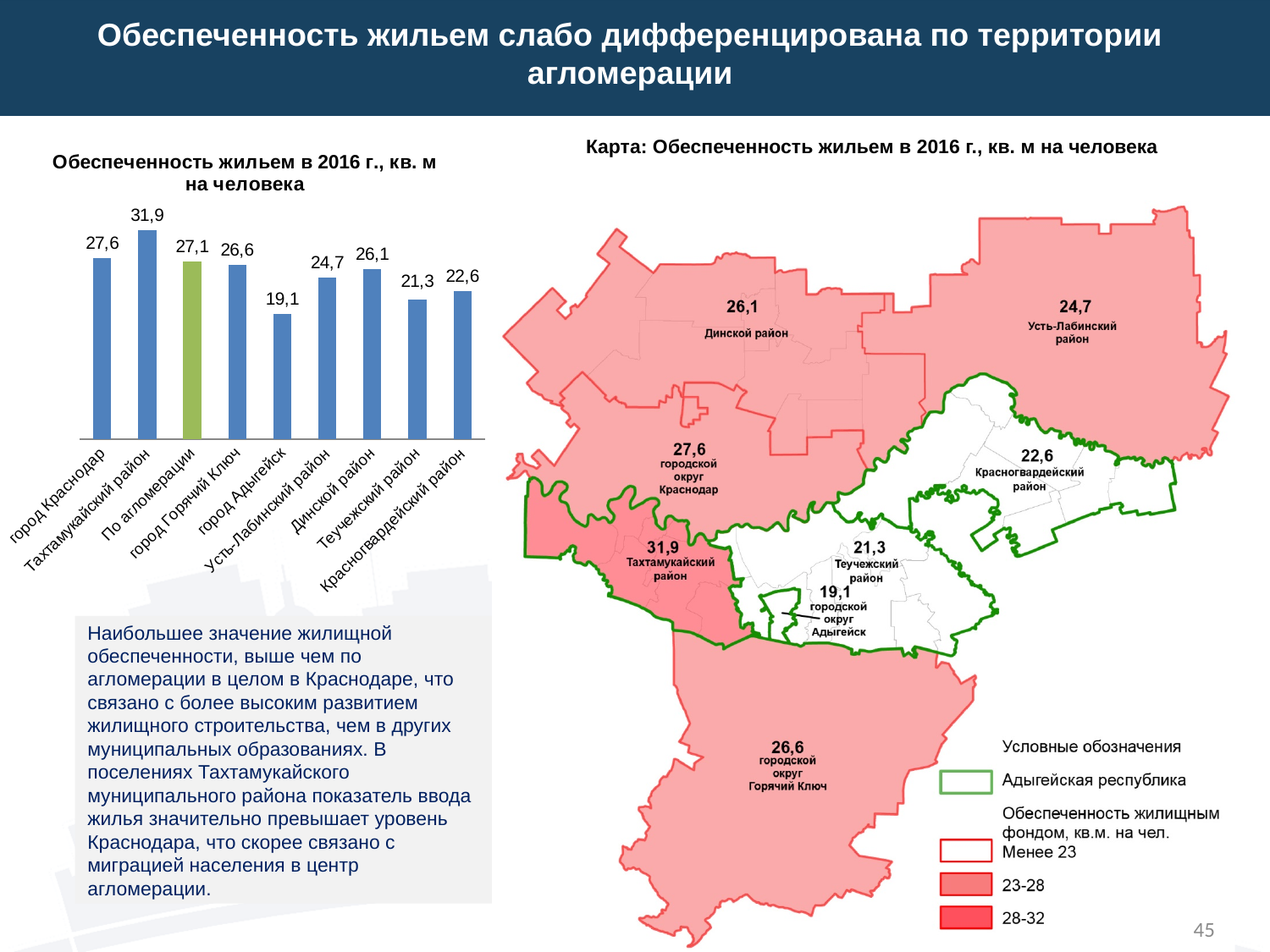
In the bar chart, what is the value for По агломерации? 27,1 What type of chart is shown on the left of the slide? bar chart In the bar chart, which category has the highest value? Тахтамукайский район In the bar chart, which category's bar is coloured green instead of blue? По агломерации In the bar chart, what is the value for Теучежский район? 21,3 In the bar chart, how many categories are shown? 9 In the bar chart, what is the difference between the values for Тахтамукайский район and город Адыгейск? 12,8 In the bar chart, which is larger: the value for Усть-Лабинский район or the value for Динской район? Динской район In the bar chart, what is the value for Тахтамукайский район? 31,9 What is the title of the bar chart on the left of the slide? Обеспеченность жильем в 2016 г., кв. м на человека In the bar chart, which category has the lowest value? город Адыгейск In the bar chart, what is the value for город Краснодар? 27,6